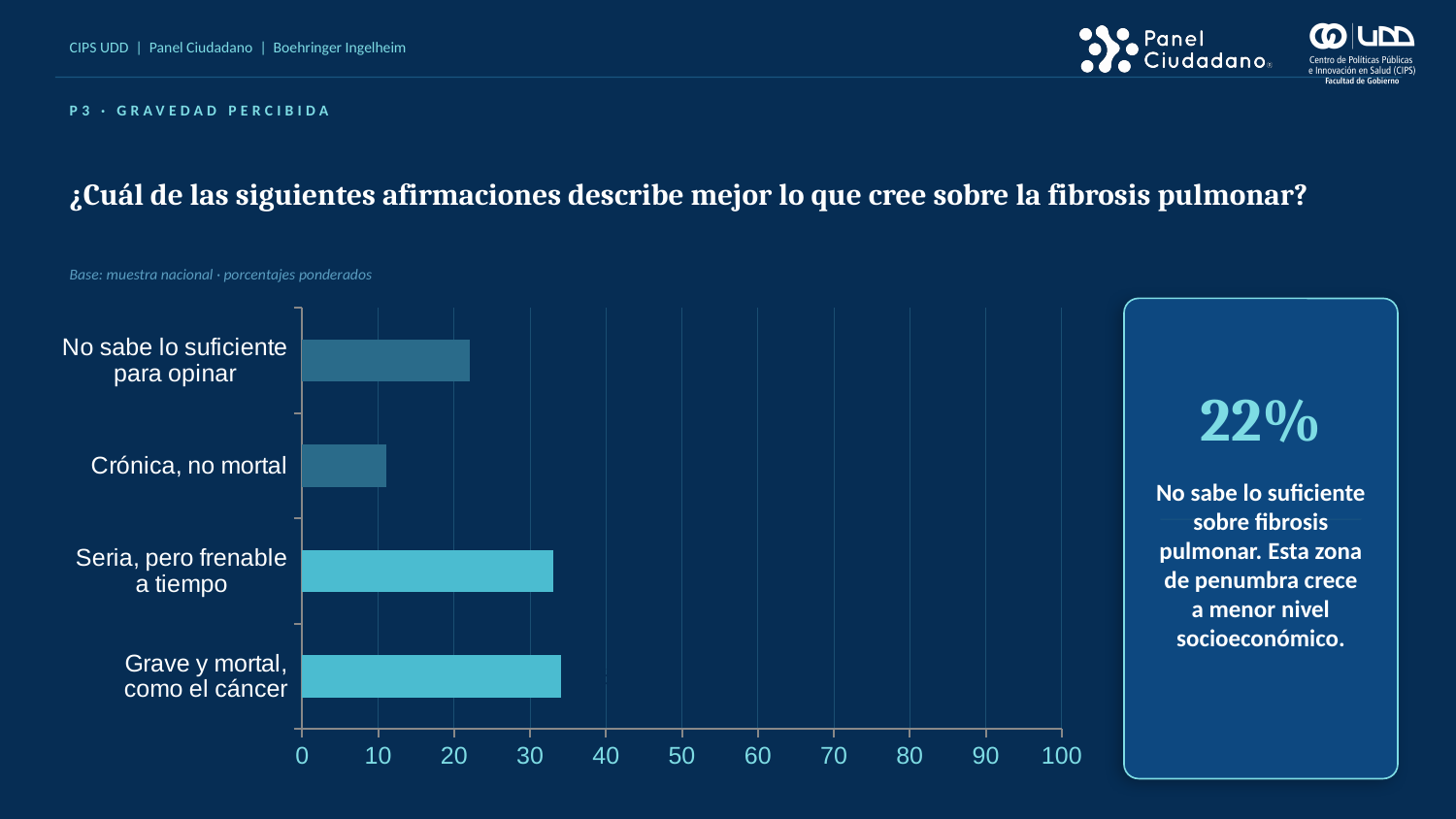
What is the maximum value shown on the horizontal axis of the chart? 100 Which is larger: the value for 'Seria, pero frenable a tiempo' or the value for 'Crónica, no mortal'? Seria, pero frenable a tiempo Which is larger: the value for 'Grave y mortal, como el cáncer' or the value for 'No sabe lo suficiente para opinar'? Grave y mortal, como el cáncer Is the value for 'Seria, pero frenable a tiempo' greater or less than 30? greater What question does the chart title ask? ¿Cuál de las siguientes afirmaciones describe mejor lo que cree sobre la fibrosis pulmonar? What kind of chart is shown on the slide? bar chart Which category has the lowest value in the chart? Crónica, no mortal Is the value for 'Crónica, no mortal' greater or less than 20? less Is the value for 'No sabe lo suficiente para opinar' greater or less than 30? less According to the slide, what percentage corresponds to 'No sabe lo suficiente para opinar'? 22% How many categories are plotted in the chart? 4